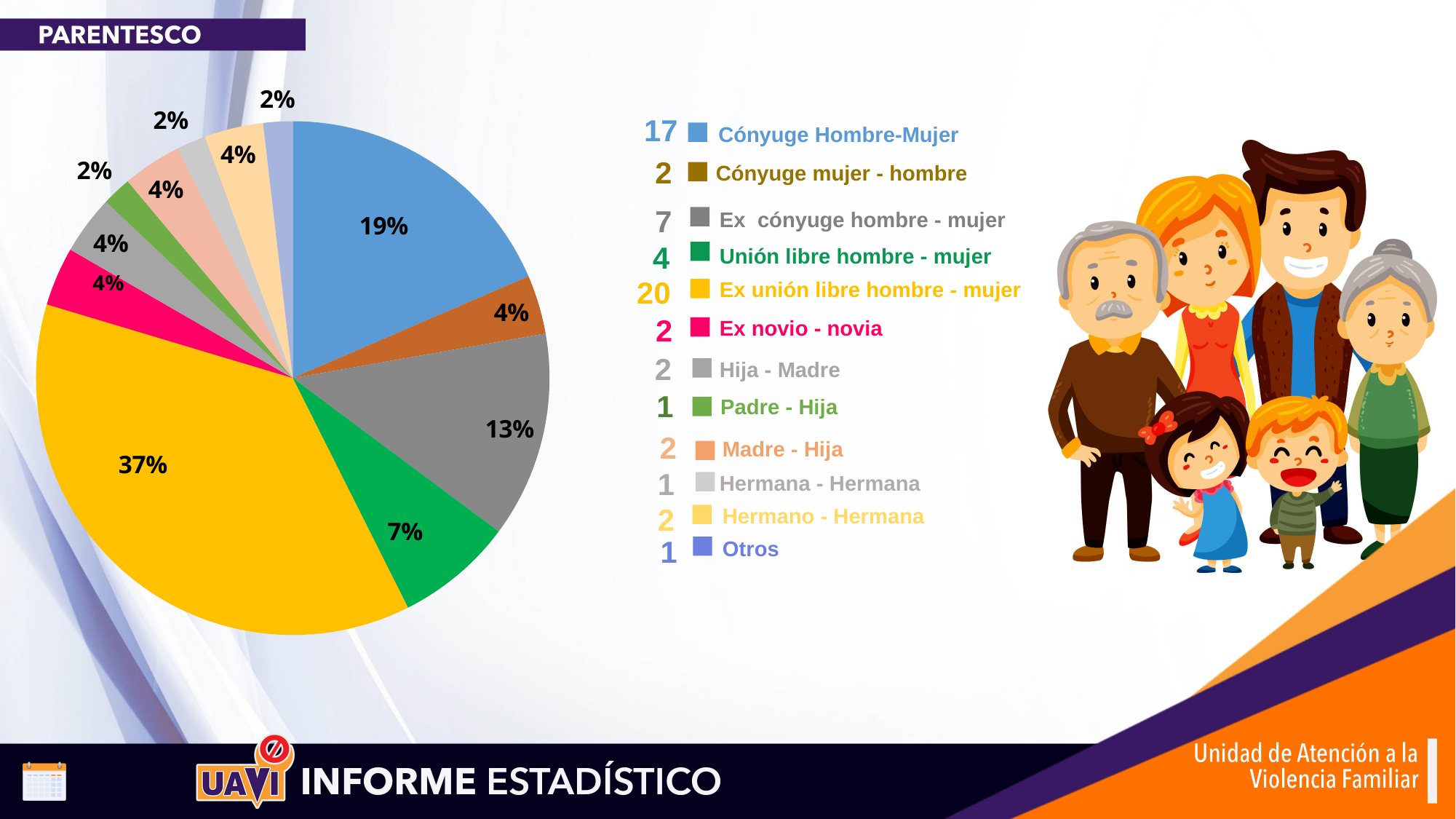
How many categories does the legend of the pie chart list? 12 What count is listed in the legend for Ex unión libre hombre - mujer? 20 What percentage of the pie does the Ex unión libre hombre - mujer slice represent? 37% What percentage is shown for the Cónyuge Hombre-Mujer slice? 19% Which slice is larger, Ex cónyuge hombre - mujer or Unión libre hombre - mujer? Ex cónyuge hombre - mujer Which category has the largest slice of the pie chart? Ex unión libre hombre - mujer What percentage is shown for the Unión libre hombre - mujer slice? 7% What percentage is shown for the Ex cónyuge hombre - mujer slice? 13% What is the difference in percentage points between the Ex unión libre hombre - mujer slice and the Cónyuge Hombre-Mujer slice? 18% What kind of chart is shown on the slide? pie chart What count is listed in the legend for Cónyuge Hombre-Mujer? 17 What is the title shown above the pie chart? PARENTESCO